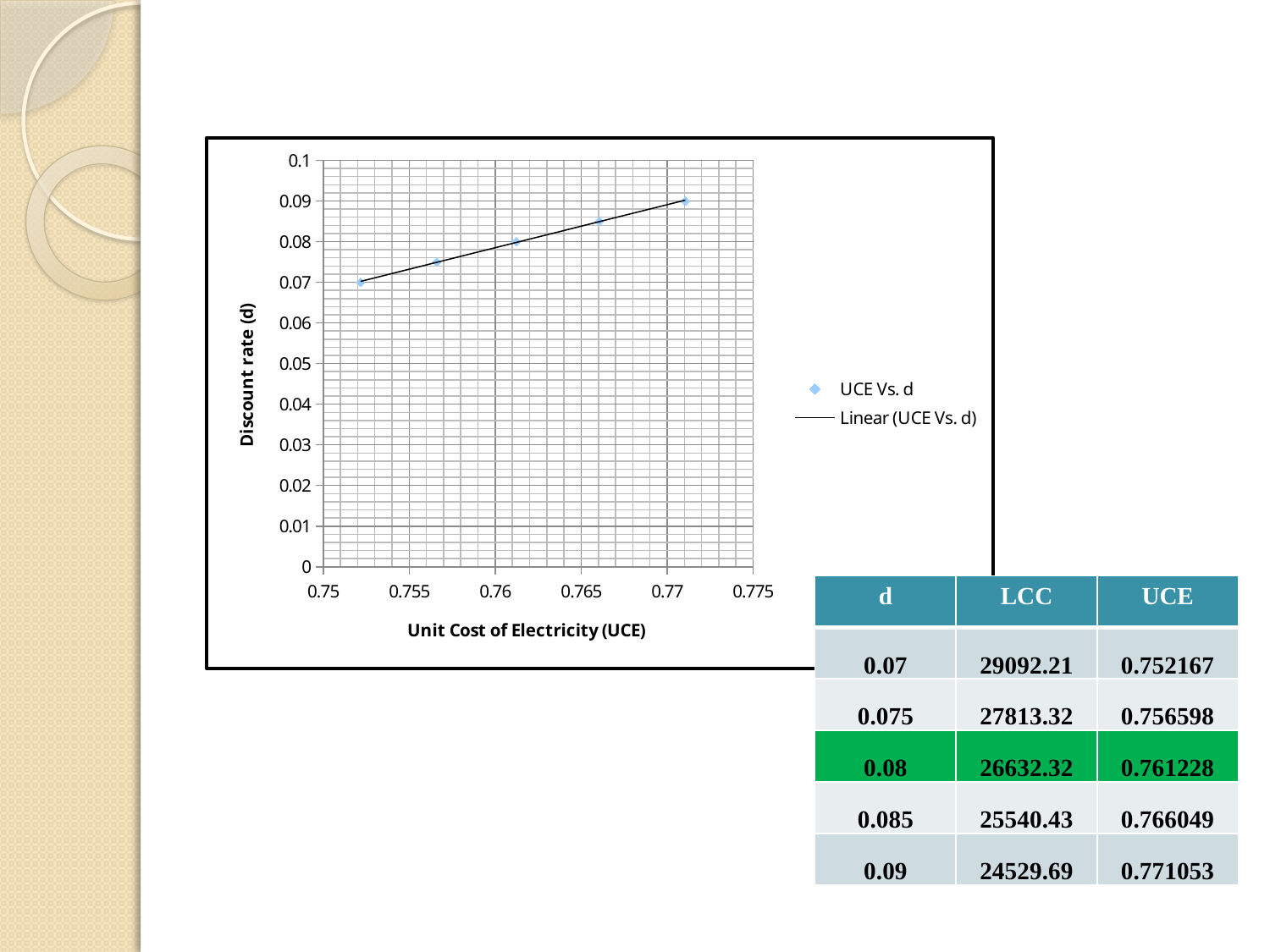
Does the discount rate (d) rise or fall as the Unit Cost of Electricity (UCE) increases along the x axis? Rise Is the discount rate of the second-lowest point (just above UCE 0.755) greater or less than 0.08? less How many entries does the chart's legend list? 2 Which point has the higher discount rate: the one at the lowest UCE or the one at the highest UCE? The one at the highest UCE What are the two entries listed in the chart's legend? UCE Vs. d; Linear (UCE Vs. d) What is the difference between the highest and lowest discount rate values plotted? 0.02 What is the lowest discount rate (d) plotted in the chart? 0.07 What kind of chart is shown on the slide? Scatter chart with a linear trendline What is the highest discount rate (d) plotted in the chart? 0.09 Is the largest UCE value plotted greater or less than 0.775? less What is the title of the chart's x axis? Unit Cost of Electricity (UCE) How many data points are plotted in the UCE Vs. d chart? 5